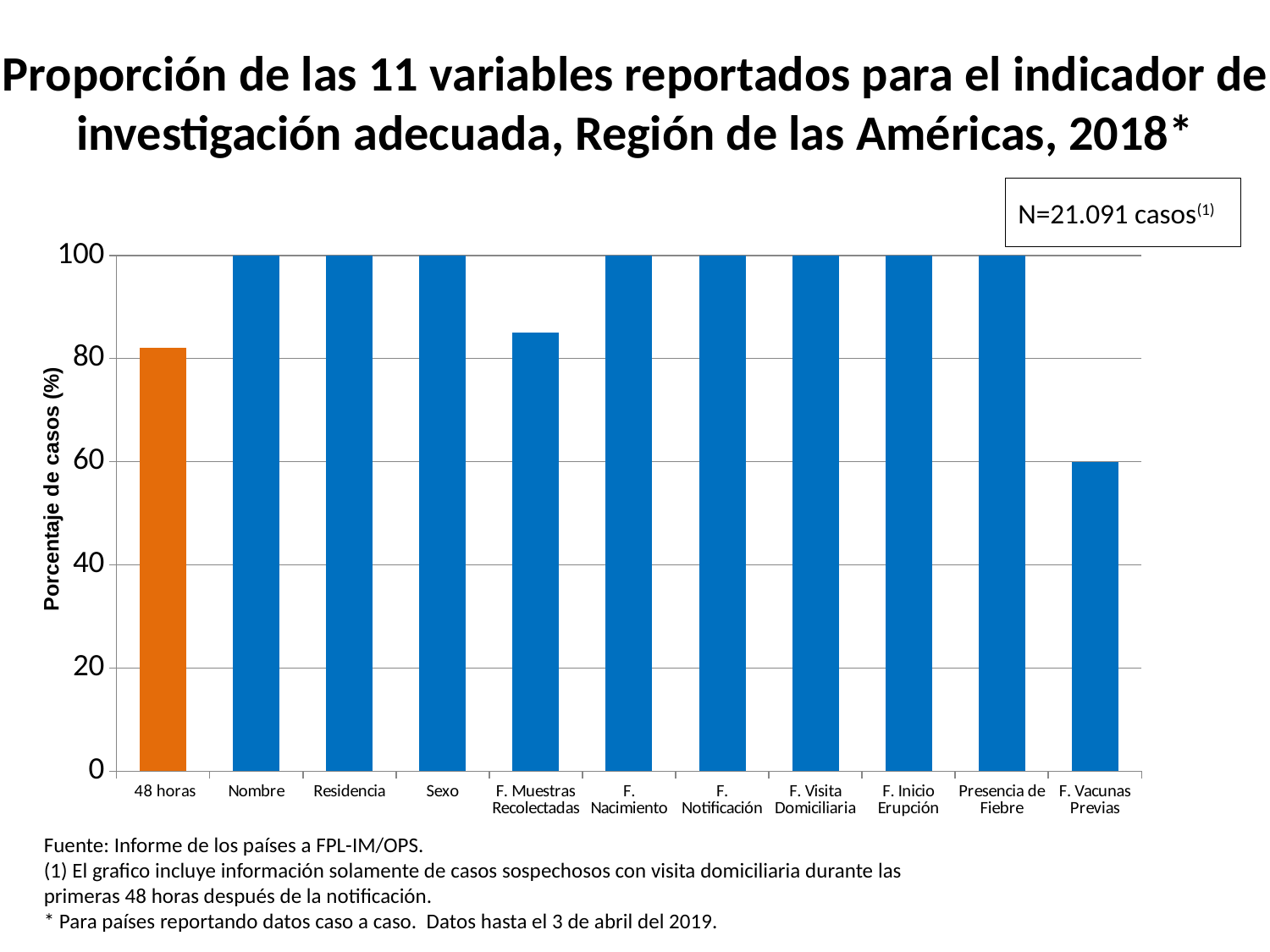
Which variable has the lowest percentage of cases? F. Vacunas Previas Which is larger, the value for 48 horas or the value for F. Vacunas Previas? 48 horas What colour is the bar for 48 horas? Orange What is the title of the y axis? Porcentaje de casos (%) What is the percentage of cases for Presencia de Fiebre? 100 How many variables (categories) are plotted on the x axis? 11 Is the value for 48 horas greater or less than 80? greater What is the difference between the value for Sexo and the value for F. Vacunas Previas? 40 What kind of chart is shown on the slide? Bar chart Is the value for F. Muestras Recolectadas greater or less than 100? less What is the percentage of cases for F. Vacunas Previas? 60 What is the percentage of cases for Nombre? 100